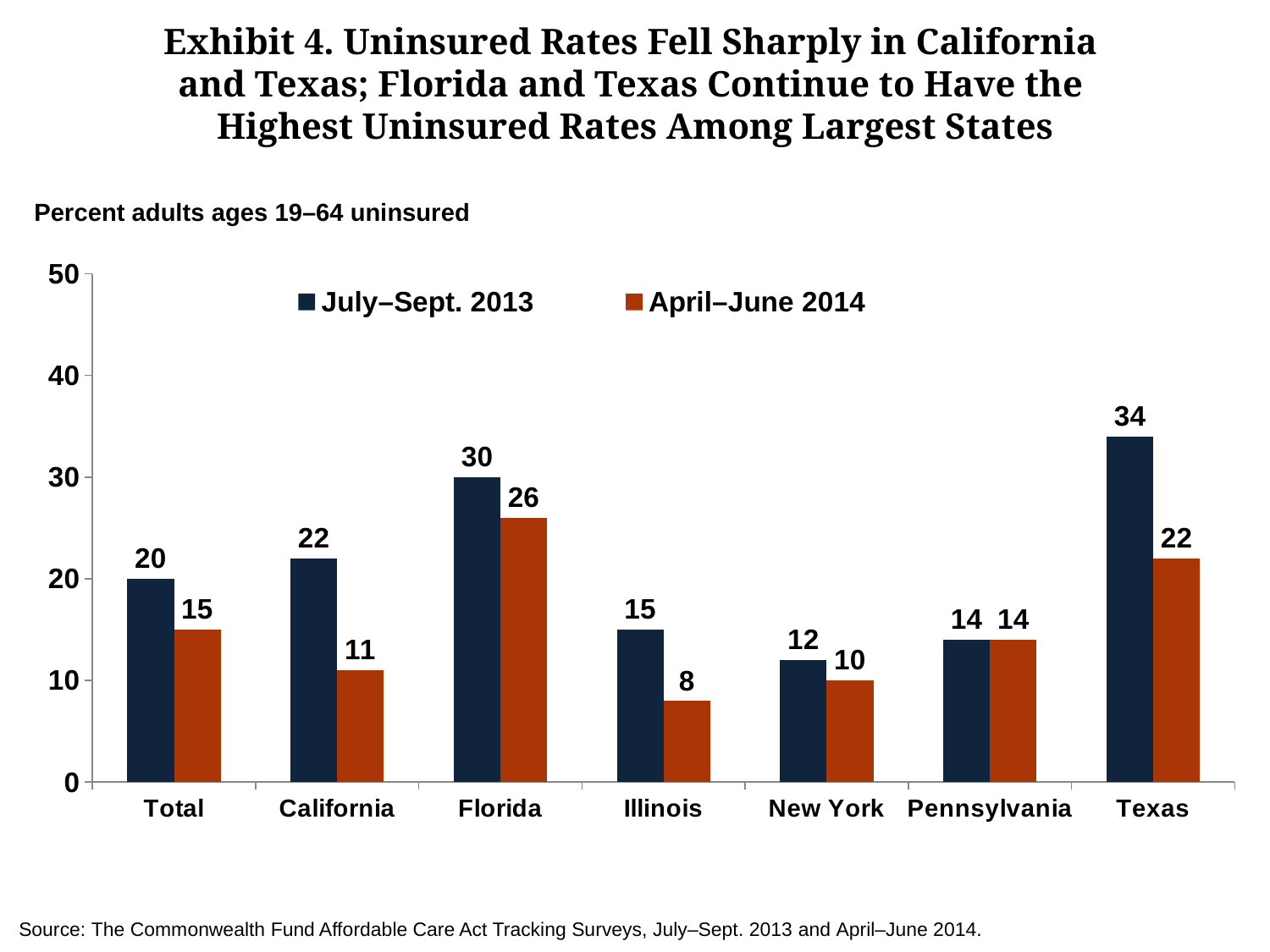
What was the uninsured rate for California in April–June 2014? 11 Which was higher in April–June 2014: the uninsured rate in Florida or in Texas? Florida Which state had the same uninsured rate in both survey periods? Pennsylvania How many series does the legend list? 2 Which state had the highest uninsured rate in April–June 2014? Florida By how many percentage points did the uninsured rate in California fall from July–Sept. 2013 to April–June 2014? 11 What is the difference between the Texas and Florida uninsured rates in July–Sept. 2013? 4 What kind of chart is shown on the slide? Bar chart Which state had the lowest uninsured rate in April–June 2014? Illinois What was the uninsured rate for Texas in July–Sept. 2013? 34 What was the uninsured rate for Illinois in April–June 2014? 8 How many categories are shown on the x axis? 7